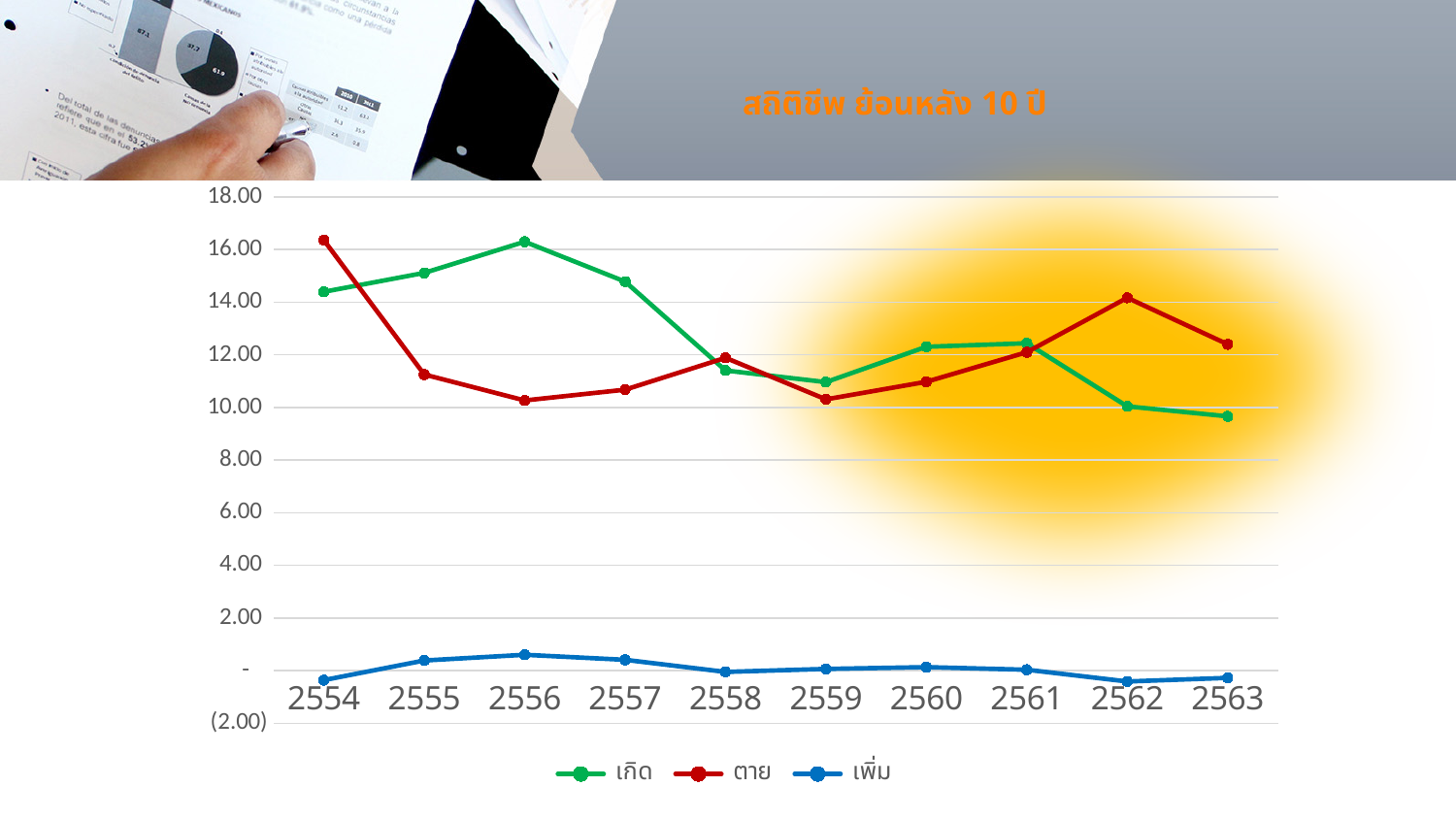
In 2556, which is larger, เกิด or ตาย? เกิด In which year is the ตาย series at its highest? 2554 Is the value for ตาย in 2556 greater or less than 12.00? less Is the value for ตาย in 2562 greater or less than 12.00? greater Which series is drawn in green? เกิด What is the title of the chart? สถิติชีพ ย้อนหลัง 10 ปี In which year is the เกิด series at its highest? 2556 How many series does the legend list? 3 Does the เกิด series rise or fall from 2556 to 2563? fall What kind of chart is shown on the slide? Line chart In 2554, which is larger, เกิด or ตาย? ตาย How many years are plotted along the x axis? 10